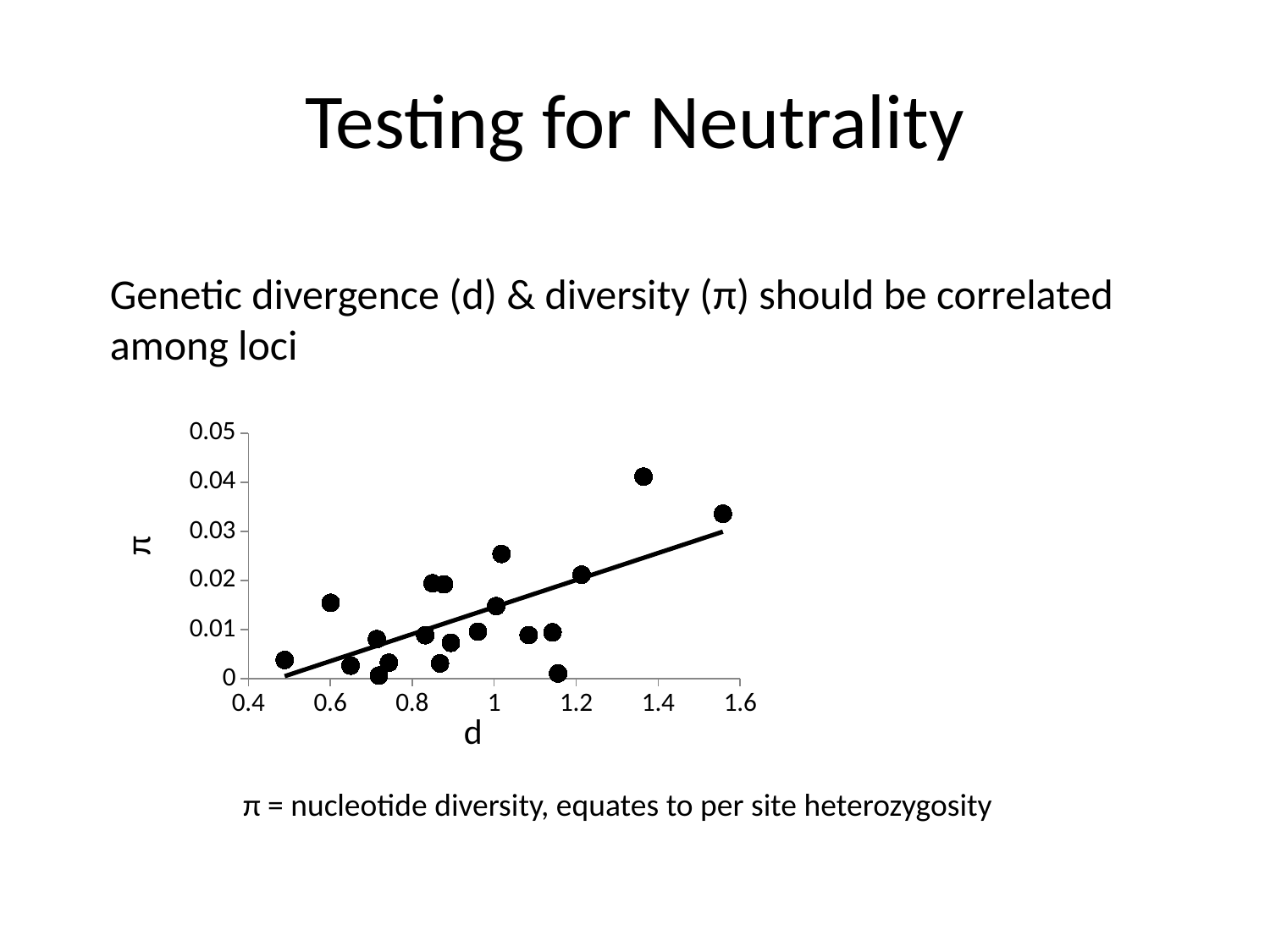
Is the π value of the point near d = 1.21 greater or less than 0.03? less What is the highest value shown on the y axis of the chart? 0.05 Is the π value of the rightmost point (near d = 1.56) greater or less than 0.03? greater What kind of chart is shown on the slide? scatter plot Is the π value of the point near d = 0.6 greater or less than 0.01? greater What is the label of the x axis of the chart? d Does the fitted line in the chart rise or fall as d increases? rise What is the lowest value shown on the x axis of the chart? 0.4 What is the highest value shown on the x axis of the chart? 1.6 What is the label of the y axis of the chart? π Which has the higher π value: the point near d = 1.36 or the point near d = 1.56? the point near d = 1.36